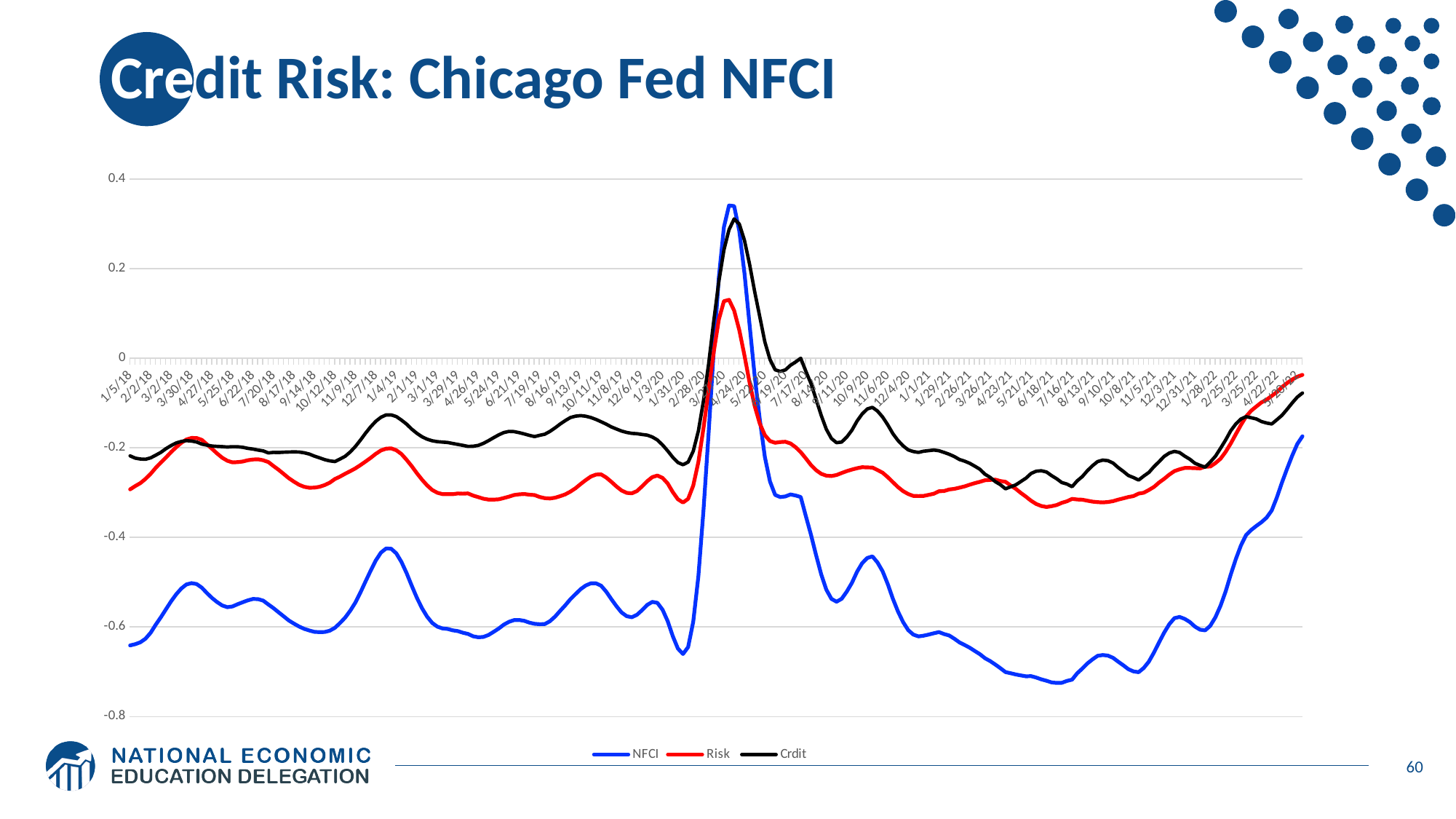
How many series does the legend list? 3 At 1/5/18, which is higher, Risk or NFCI? Risk Which series reaches the highest value on the chart, at its peak in spring 2020? NFCI Which series has the lowest values for most of the period shown? NFCI What kind of chart is shown on the slide? line chart What are the three series named in the legend? NFCI, Risk, Crdit Is the peak value of Risk in spring 2020 greater or less than 0.2? less Is the value of NFCI at 1/5/18 greater or less than -0.6? less Which colour is used for the NFCI series? blue Is the value of Risk at 1/5/18 greater or less than -0.4? greater Does the NFCI series rise or fall between 1/28/22 and the end of the chart? rise